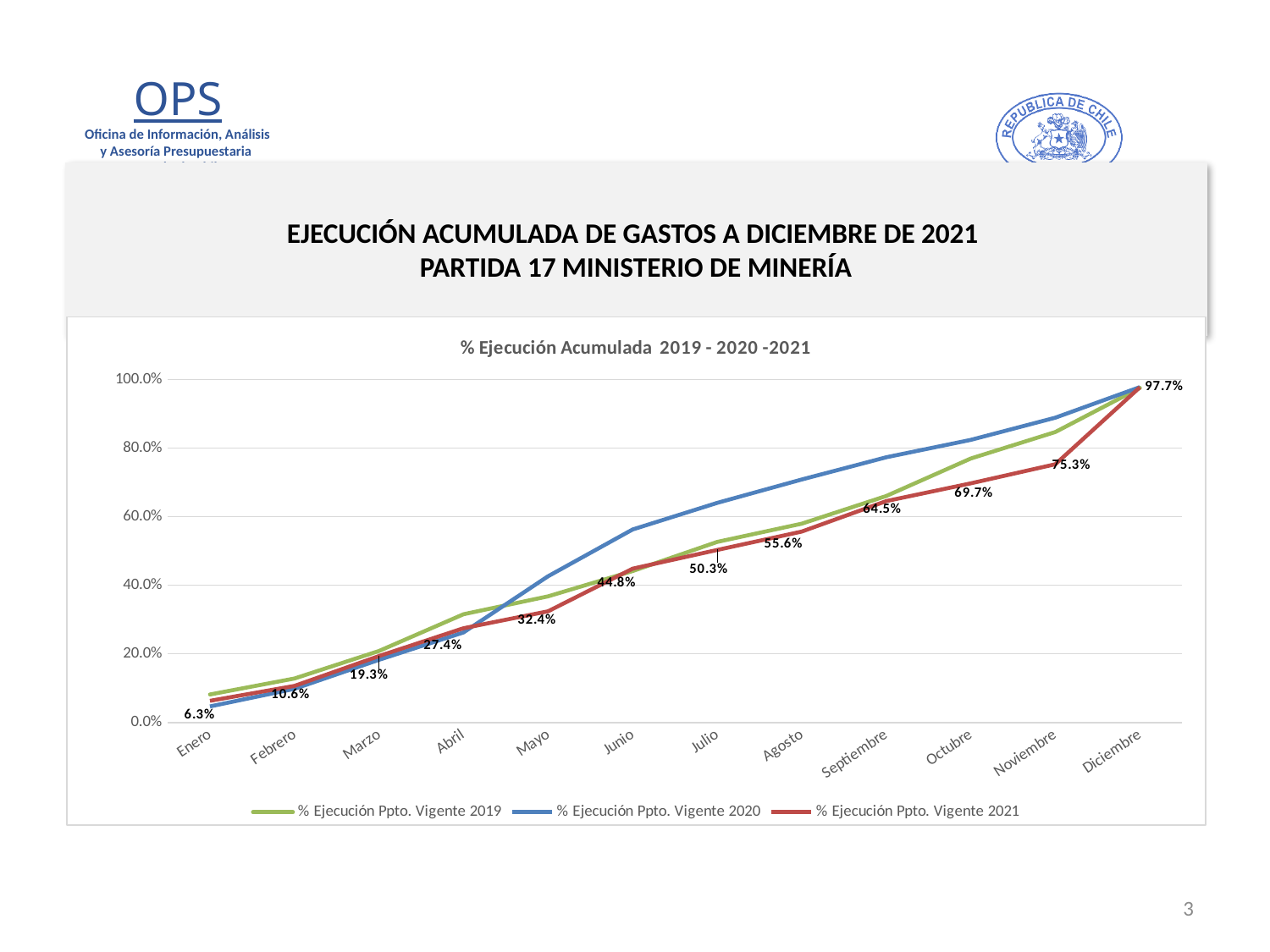
How many series does the legend list? 3 What is the value for % Ejecución Ppto. Vigente 2021 in Junio? 44.8% In which month is the 2021 series at its lowest value? Enero What is the value for % Ejecución Ppto. Vigente 2021 in Enero? 6.3% Does the 2021 series rise or fall from Enero to Diciembre? rise What is the value for % Ejecución Ppto. Vigente 2021 in Diciembre? 97.7% What is the difference between the 2021 values for Diciembre and Noviembre? 22.4% How many months are plotted along the x axis? 12 What type of chart is shown on the slide? line chart What is the value for % Ejecución Ppto. Vigente 2021 in Noviembre? 75.3% Is the value for % Ejecución Ppto. Vigente 2020 in Junio greater or less than 40.0%? greater What is the title of the chart? % Ejecución Acumulada 2019 - 2020 -2021